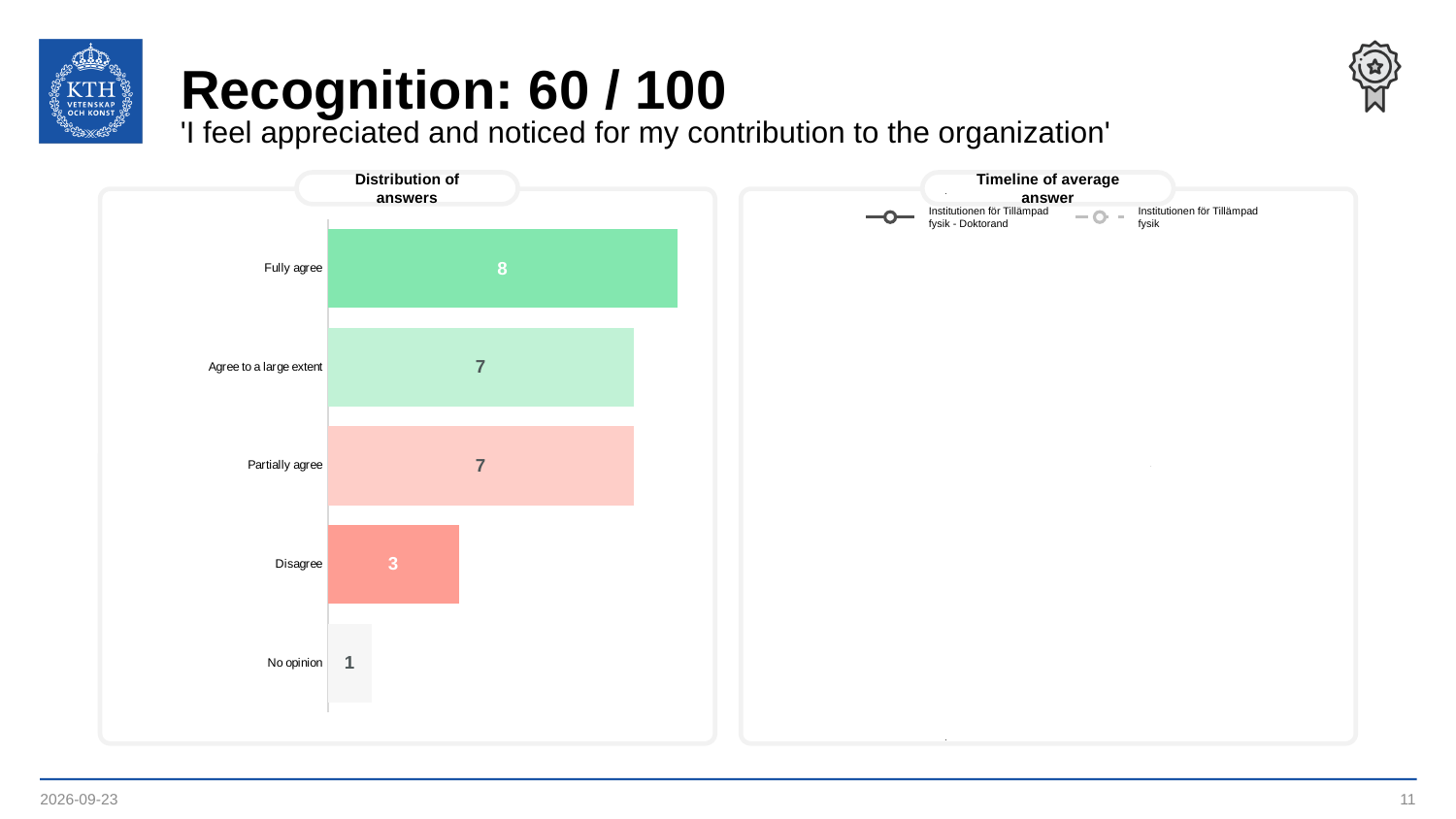
In the 'Distribution of answers' chart, which category has the lowest value? No opinion How many series does the legend of the 'Timeline of average answer' chart list? 2 In the 'Distribution of answers' chart, which is larger: the value for 'Agree to a large extent' or the value for 'Disagree'? Agree to a large extent In the 'Distribution of answers' chart, what is the difference between the values for 'Fully agree' and 'Disagree'? 5 What kind of chart is the 'Distribution of answers' chart? Bar chart In the 'Distribution of answers' chart, what is the value for 'No opinion'? 1 In the 'Distribution of answers' chart, what is the total of all the answer counts? 26 In the 'Distribution of answers' chart, what is the value for 'Partially agree'? 7 How many categories are shown in the 'Distribution of answers' chart? 5 In the 'Distribution of answers' chart, what is the value for 'Disagree'? 3 In the 'Distribution of answers' chart, which category has the highest value? Fully agree In the 'Distribution of answers' chart, what is the value for 'Fully agree'? 8